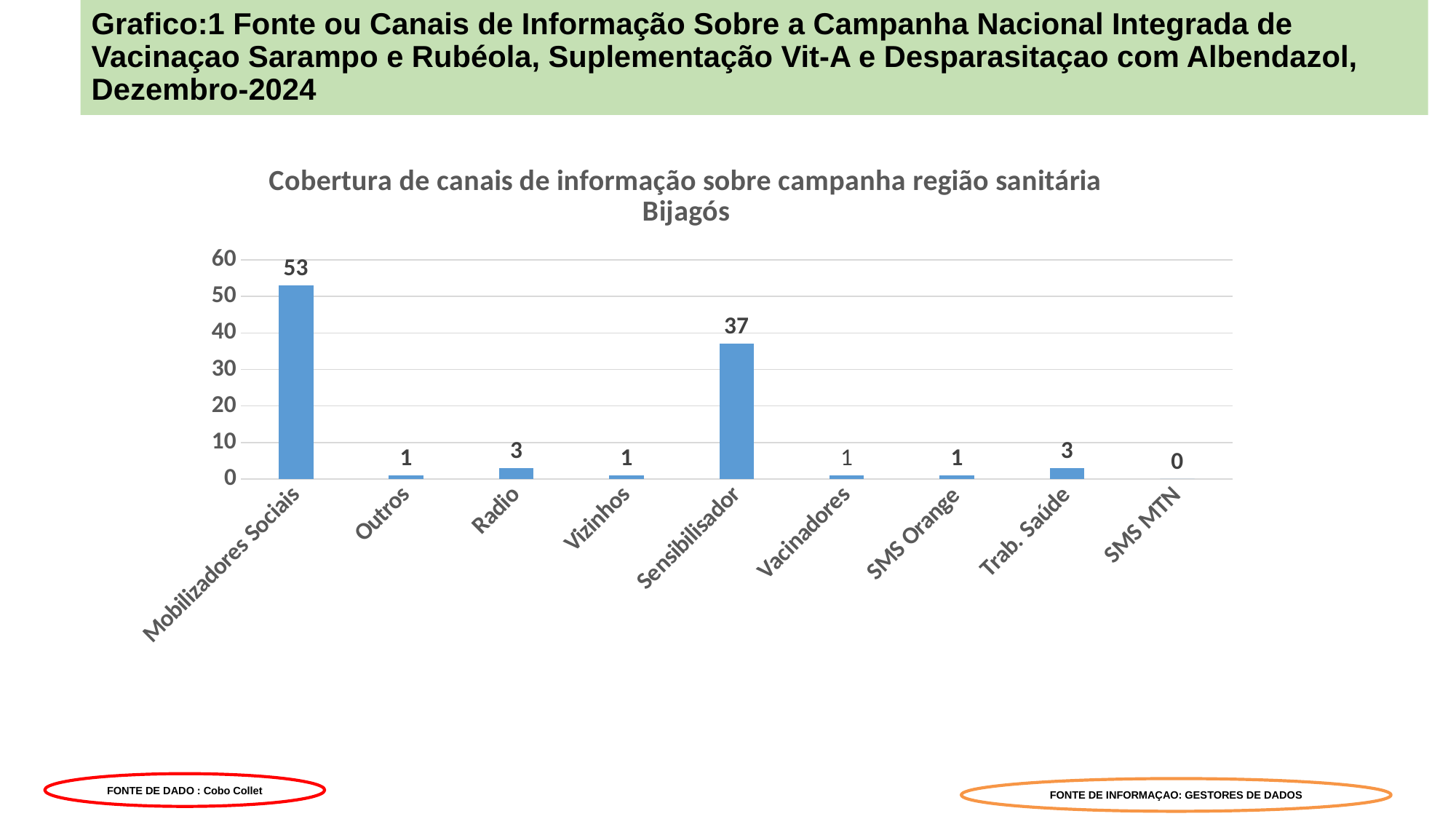
How many categories are shown on the x axis? 9 Is the value for Sensibilisador greater or less than 30? greater Which category has the highest value? Mobilizadores Sociais What is the title of the chart? Cobertura de canais de informação sobre campanha região sanitária Bijagós What is the difference between the values for Mobilizadores Sociais and Sensibilisador? 16 What is the value for SMS MTN? 0 Which category has the lowest value? SMS MTN What is the value for Sensibilisador? 37 What kind of chart is this? bar chart What is the value for Mobilizadores Sociais? 53 What is the value for Radio? 3 Which is larger, the value for Trab. Saúde or the value for Vacinadores? Trab. Saúde